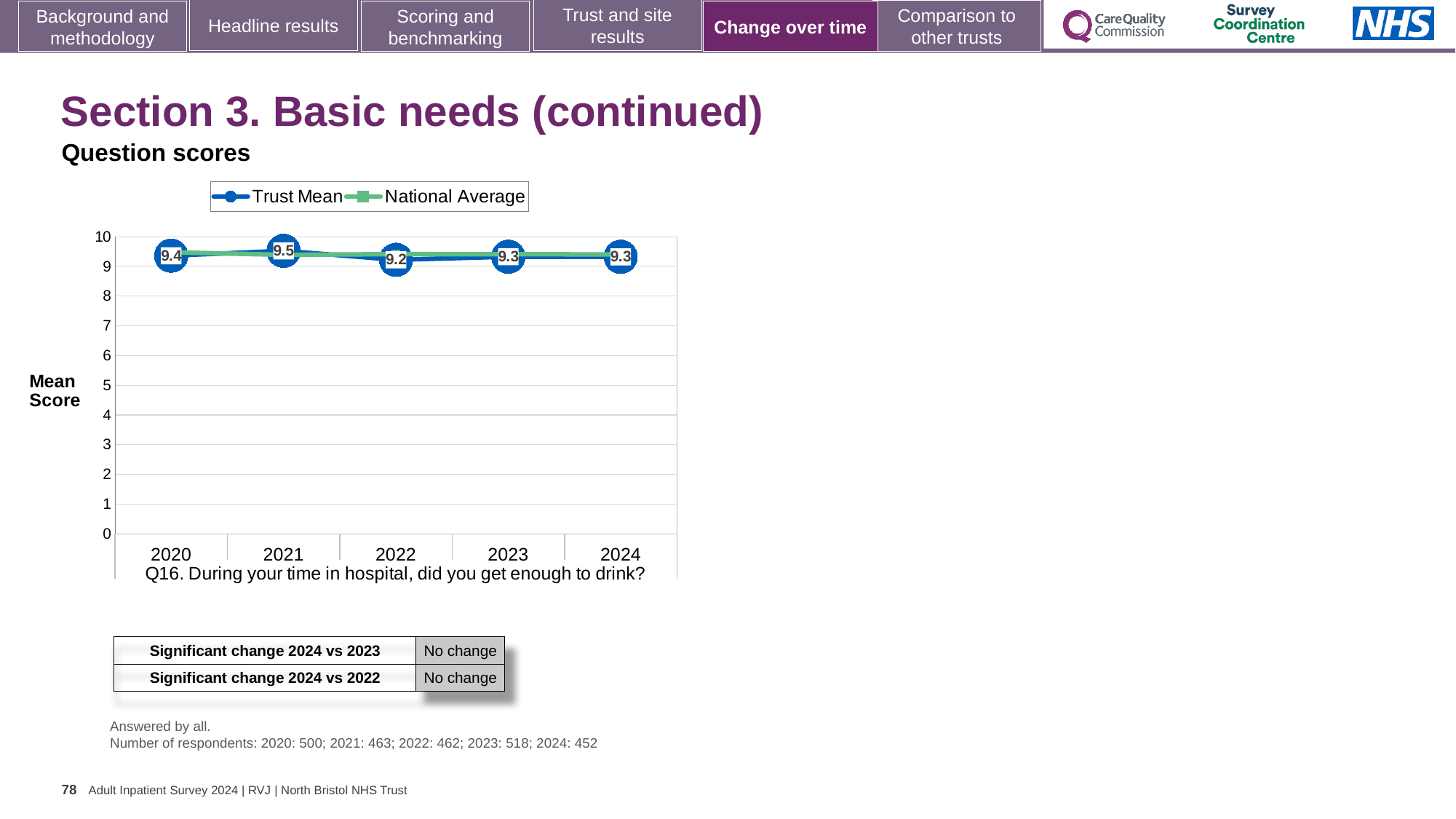
What is the Trust Mean score for 2024? 9.3 How many years are plotted on the x axis? 5 In which year is the Trust Mean score highest? 2021 Does the Trust Mean score rise or fall from 2021 to 2022? Fall In which year is the Trust Mean score lowest? 2022 What is the Trust Mean score for 2020? 9.4 What kind of chart is shown on the slide? Line chart What is the difference between the Trust Mean scores for 2021 and 2022? 0.3 How many series does the legend list? 2 What is the Trust Mean score for 2022? 9.2 Is the National Average value for 2023 greater or less than 5? greater Which year has the larger Trust Mean score, 2020 or 2022? 2020